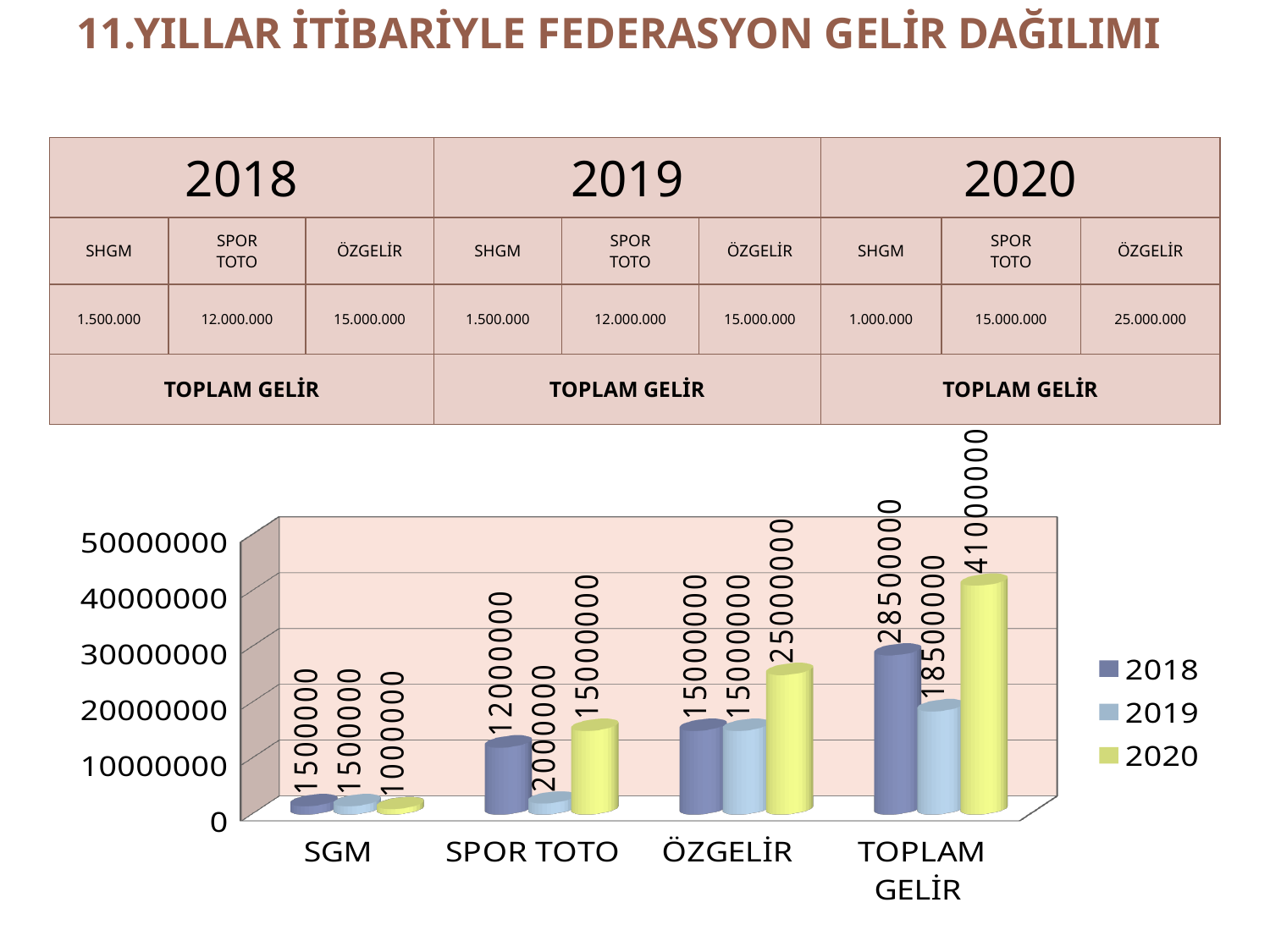
How many series does the legend list? 3 In the SPOR TOTO category, which is larger: the 2018 value or the 2019 value? 2018 How many categories are shown on the x axis? 4 What kind of chart is shown on the slide? bar chart Which category has the highest value for the 2020 series? TOPLAM GELİR What is the difference between the 2020 and 2018 values in the TOPLAM GELİR category? 12500000 What is the value for 2020 in the TOPLAM GELİR category? 41000000 What is the value for 2020 in the SGM category? 1000000 What is the value for 2018 in the SPOR TOTO category? 12000000 What is the value for 2019 in the ÖZGELİR category? 15000000 Which category has the lowest value for the 2018 series? SGM Is the 2020 value for ÖZGELİR greater or less than 20000000? greater